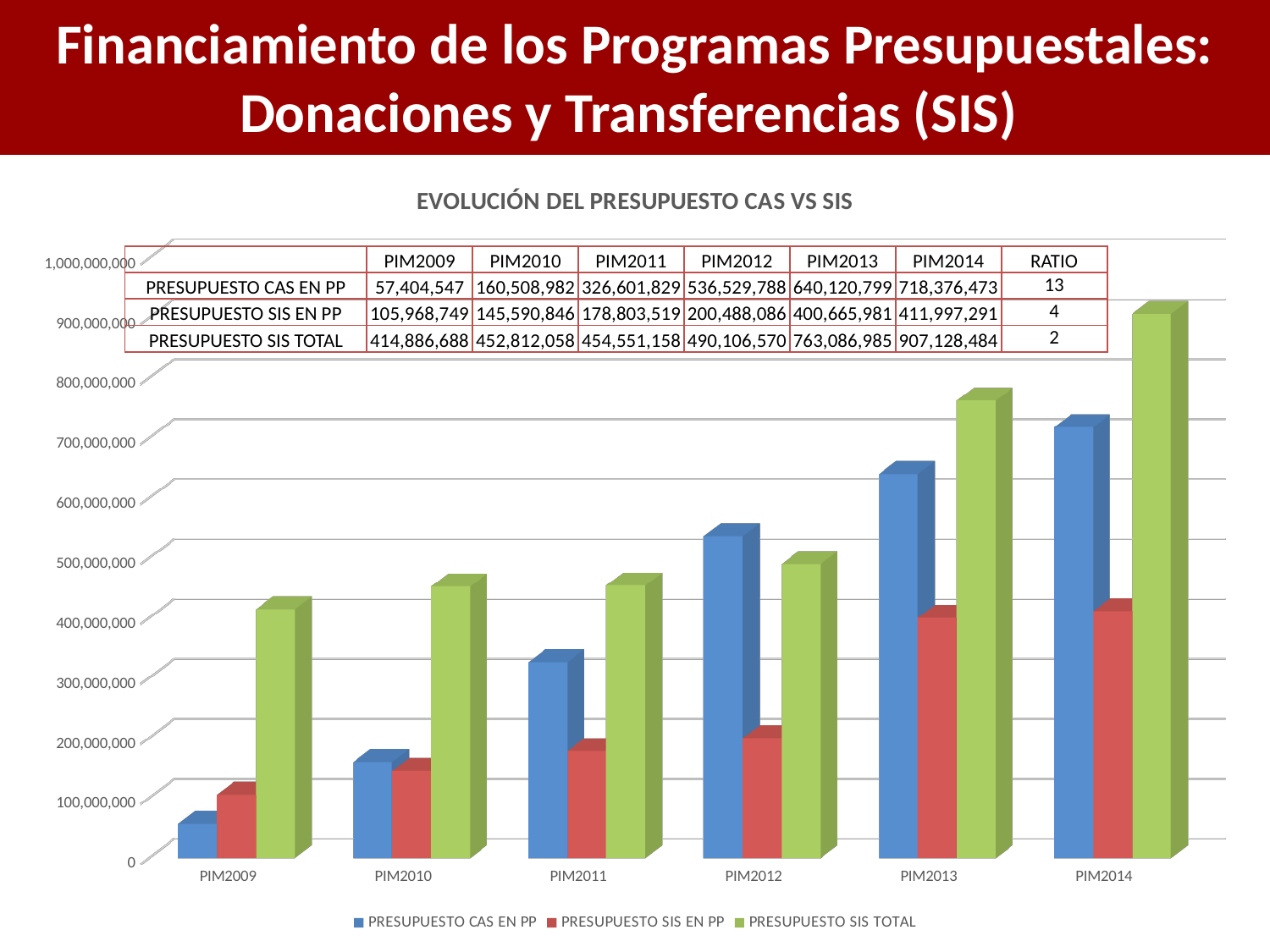
What is the difference between PRESUPUESTO SIS TOTAL and PRESUPUESTO CAS EN PP in PIM2014? 188,752,011 How many years (categories) are shown on the x axis? 6 Which year has the highest value for PRESUPUESTO SIS TOTAL? PIM2014 Is the value for PRESUPUESTO SIS TOTAL in PIM2013 greater or less than 700,000,000? greater Does PRESUPUESTO CAS EN PP rise or fall from PIM2009 to PIM2014? rise What is the value of PRESUPUESTO CAS EN PP for PIM2012? 536,529,788 How many series does the legend list? 3 Which year has the lowest value for PRESUPUESTO CAS EN PP? PIM2009 What is the value of PRESUPUESTO SIS TOTAL for PIM2014? 907,128,484 Which is larger in PIM2009: PRESUPUESTO CAS EN PP or PRESUPUESTO SIS EN PP? PRESUPUESTO SIS EN PP What kind of chart is shown? bar chart What is the value of PRESUPUESTO SIS EN PP for PIM2009? 105,968,749